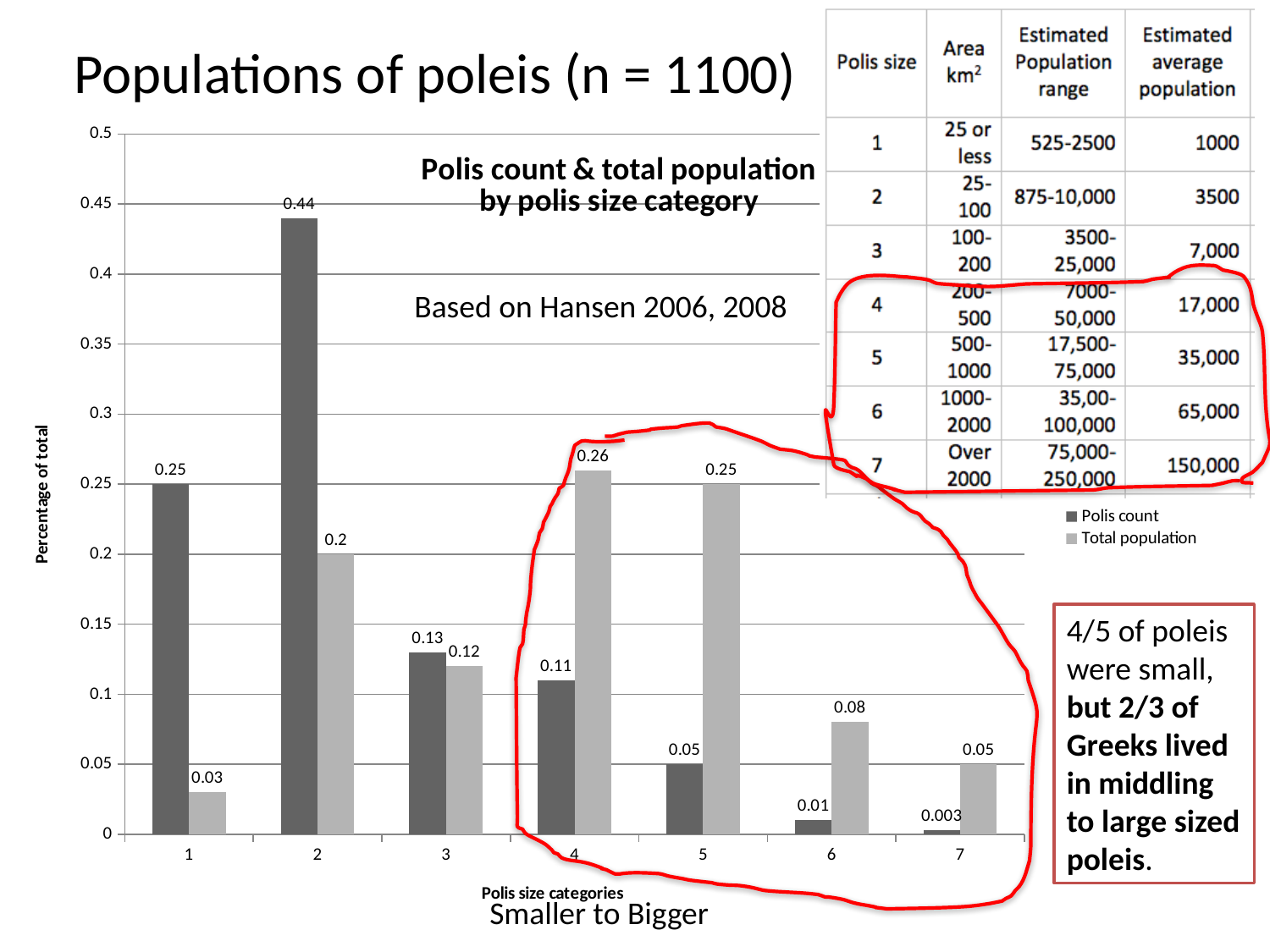
What is the Total population value for polis size category 4? 0.26 How many polis size categories are shown on the x axis of the chart? 7 Which polis size category has the lowest Total population value? 1 Does the Polis count series rise or fall from polis size category 2 to category 7? Fall What kind of chart is shown on the slide? Bar chart What is the label of the y axis of the chart? Percentage of total Which polis size category has the highest Polis count value? 2 How many series does the chart legend list? 2 What is the Polis count value for polis size category 7? 0.003 What is the Polis count value for polis size category 2? 0.44 What is the difference between the Polis count and Total population values for polis size category 1? 0.22 For polis size category 5, which is larger: Polis count or Total population? Total population